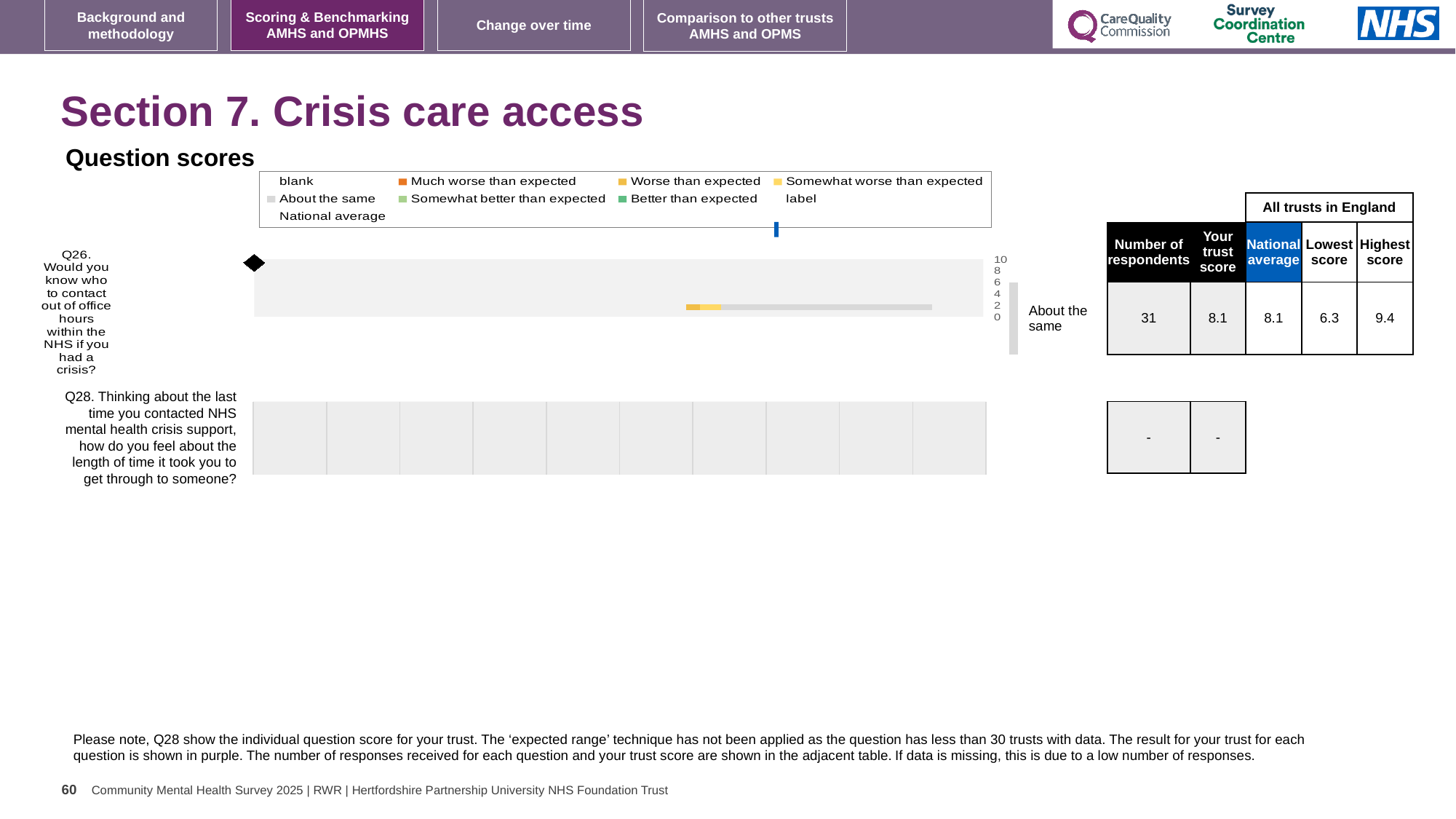
What value is shown for the number of respondents for Q28 in the table? - Is the trust score for Q26 larger than, smaller than, or equal to the national average? equal What is the lowest score among all trusts in England for Q26? 6.3 What kind of chart is used to show the question scores? bar chart What category label is shown next to the Q26 bar? About the same What is the national average for Q26 shown in the table? 8.1 How many respondents answered Q26? 31 What is the maximum value shown on the chart's score axis? 10 How many questions are plotted on the chart? 2 What is the trust score for Q26 shown in the table? 8.1 What is the highest score among all trusts in England for Q26? 9.4 What is the difference between the highest and lowest scores for Q26 across all trusts in England? 3.1